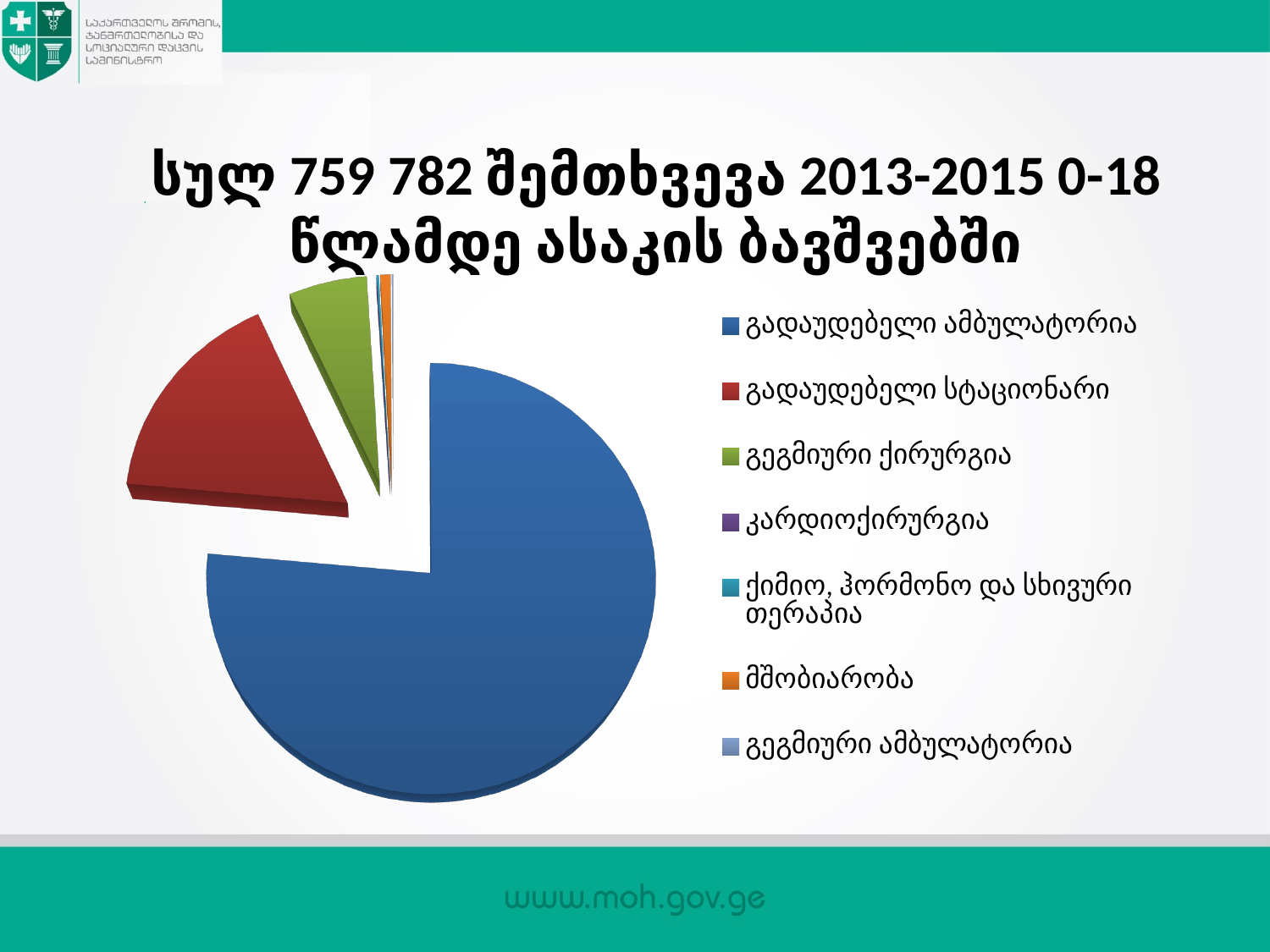
What total number of cases is stated in the slide title? 759 782 What colour is the slice for გადაუდებელი ამბულატორია? Blue Which slice is larger: გადაუდებელი სტაციონარი or გეგმიური ქირურგია? გადაუდებელი სტაციონარი Which category has the second-largest slice in the pie chart? გადაუდებელი სტაციონარი Which category has the largest slice in the pie chart? გადაუდებელი ამბულატორია How many slices does the pie chart have? 7 Which slice is larger: გადაუდებელი ამბულატორია or გადაუდებელი სტაციონარი? გადაუდებელი ამბულატორია How many categories does the legend of the pie chart list? 7 Which slice is larger: გეგმიური ქირურგია or მშობიარობა? გეგმიური ქირურგია What kind of chart is shown on the slide? Pie chart